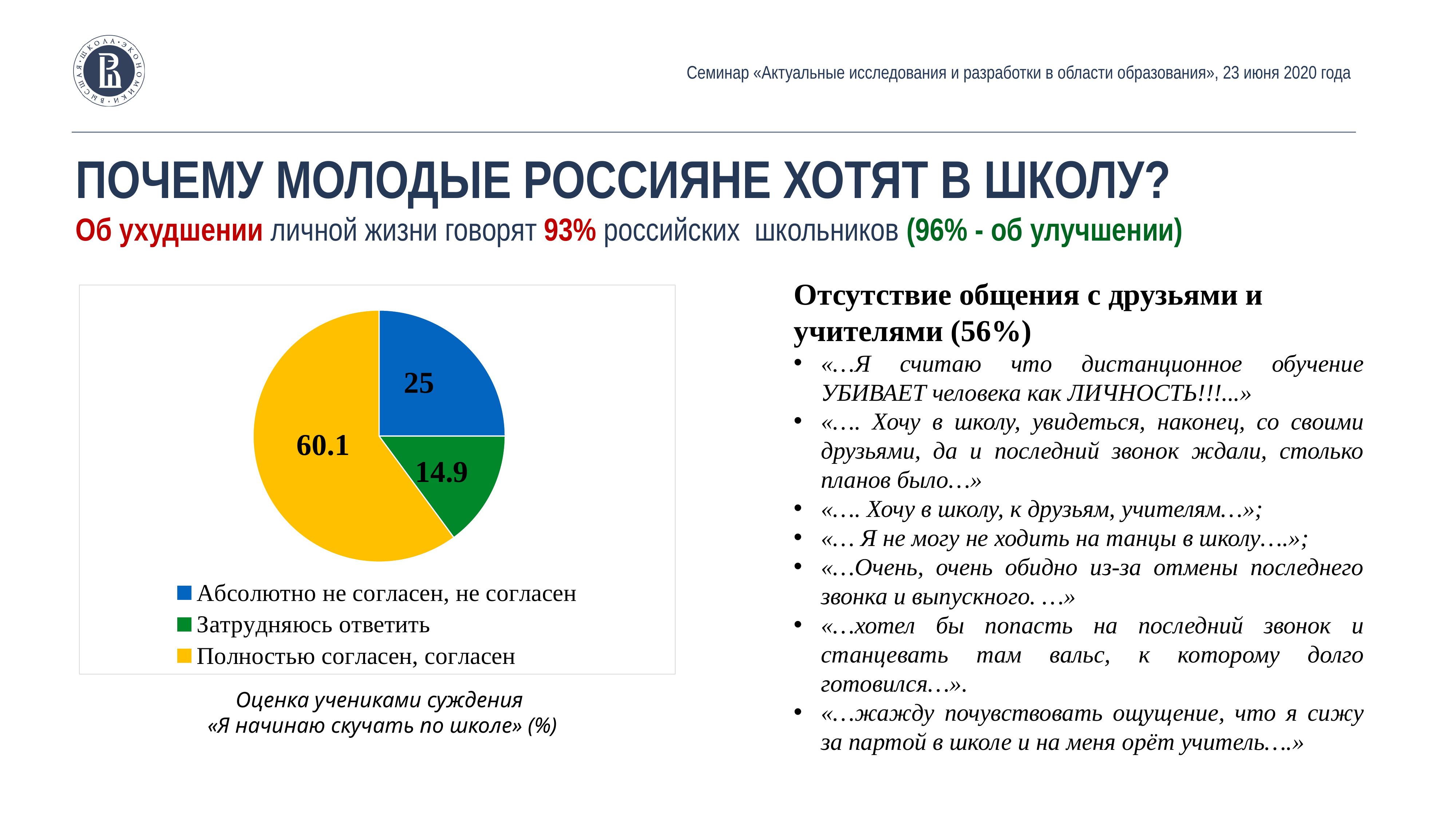
What is the difference between the values for «Полностью согласен, согласен» and «Абсолютно не согласен, не согласен»? 35.1 How many categories does the pie chart have? 3 What is the difference between the values for «Абсолютно не согласен, не согласен» and «Затрудняюсь ответить»? 10.1 What statement is being evaluated in the pie chart, according to the caption below it? «Я начинаю скучать по школе» Which category has the largest slice in the pie chart? Полностью согласен, согласен Which category has the smallest slice in the pie chart? Затрудняюсь ответить Which is larger: the value for «Абсолютно не согласен, не согласен» or for «Затрудняюсь ответить»? Абсолютно не согласен, не согласен What is the value for «Полностью согласен, согласен» in the pie chart? 60.1 What is the value for «Абсолютно не согласен, не согласен» in the pie chart? 25 What is the value for «Затрудняюсь ответить» in the pie chart? 14.9 What colour is the slice for «Затрудняюсь ответить»? green What kind of chart is shown on the slide? pie chart